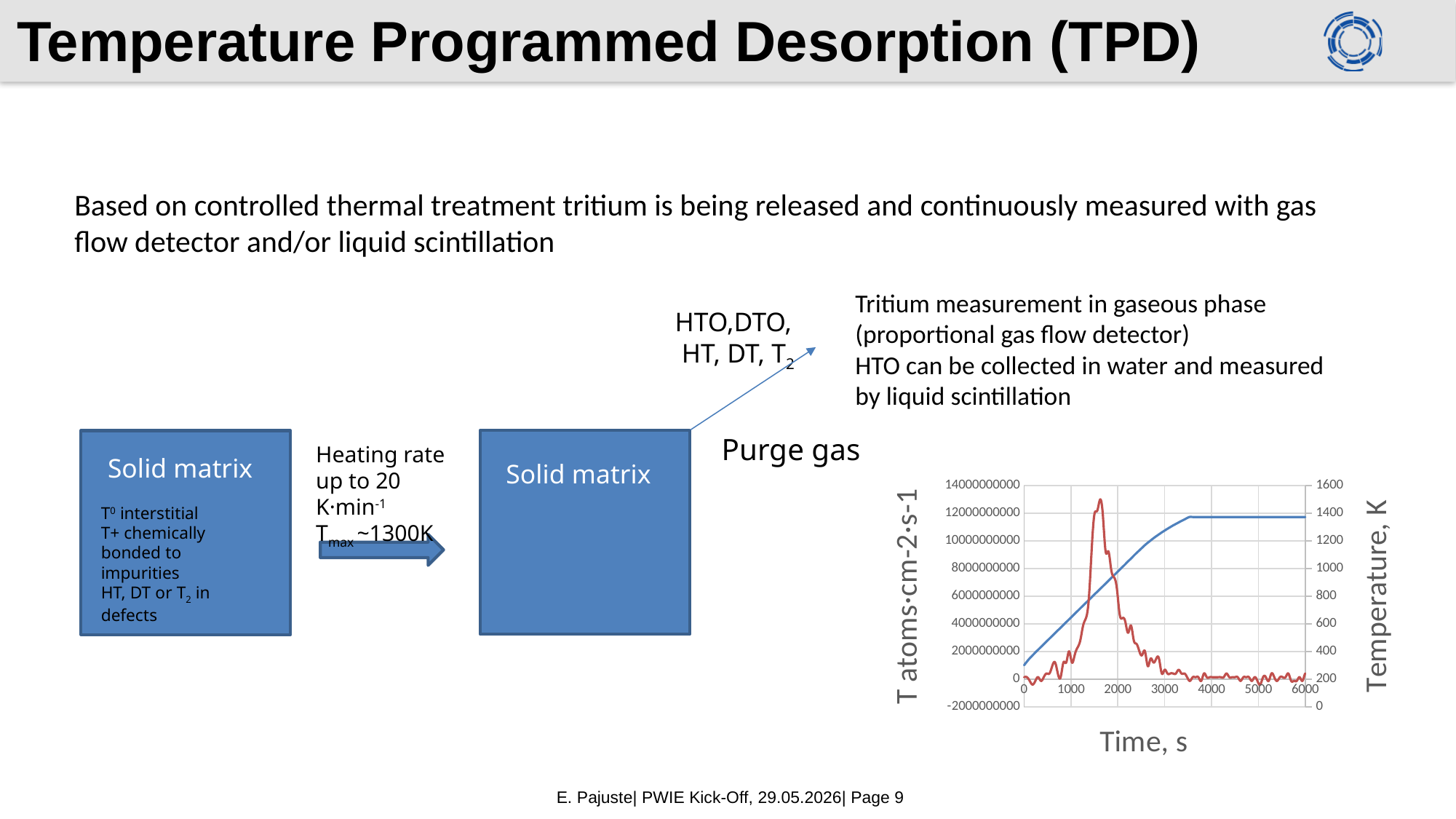
What is the maximum value shown on the right-hand temperature axis? 1600 What is the label of the right-hand y axis of the chart? Temperature, K Does the red line rise or fall between time 2000 s and time 3000 s? fall What is the maximum value shown on the x axis of the chart? 6000 What is the lowest value shown on the left-hand y axis? -2000000000 Does the blue temperature line rise or fall between time 0 and time 3000 s? rise What is the label of the x axis of the chart? Time, s Is the peak of the red line located at a time greater or less than 1000 s? greater Is the peak of the red line greater or less than 12000000000 on the left axis? greater Is the plateau value of the blue temperature line greater or less than 1200 K? greater How many lines are plotted on the chart? 2 What kind of chart is shown on the slide? line chart